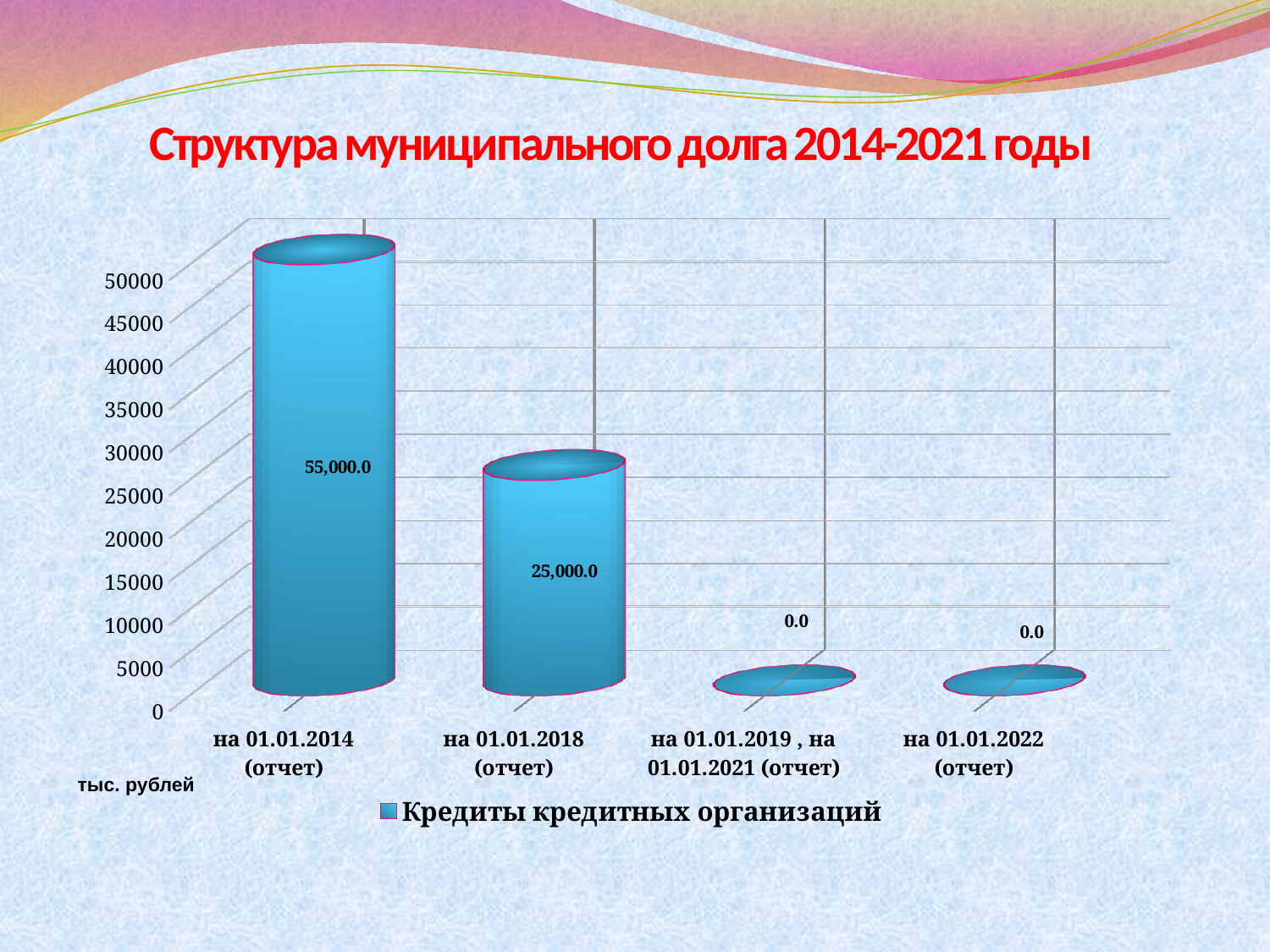
Is the value for "на 01.01.2018 (отчет)" greater or less than 30000? less How many categories are shown on the x axis? 4 What is the title of the chart? Структура муниципального долга 2014-2021 годы Which category has the highest value? на 01.01.2014 (отчет) What is the value for "на 01.01.2022 (отчет)"? 0.0 Which is larger, the value for "на 01.01.2018 (отчет)" or the value for "на 01.01.2022 (отчет)"? на 01.01.2018 (отчет) What is the difference between the values for "на 01.01.2014 (отчет)" and "на 01.01.2018 (отчет)"? 30,000.0 How many series does the legend list? 1 Do the values rise or fall from left to right along the x axis? fall What kind of chart is shown on the slide? bar chart What is the value for "на 01.01.2014 (отчет)"? 55,000.0 What is the value for "на 01.01.2018 (отчет)"? 25,000.0